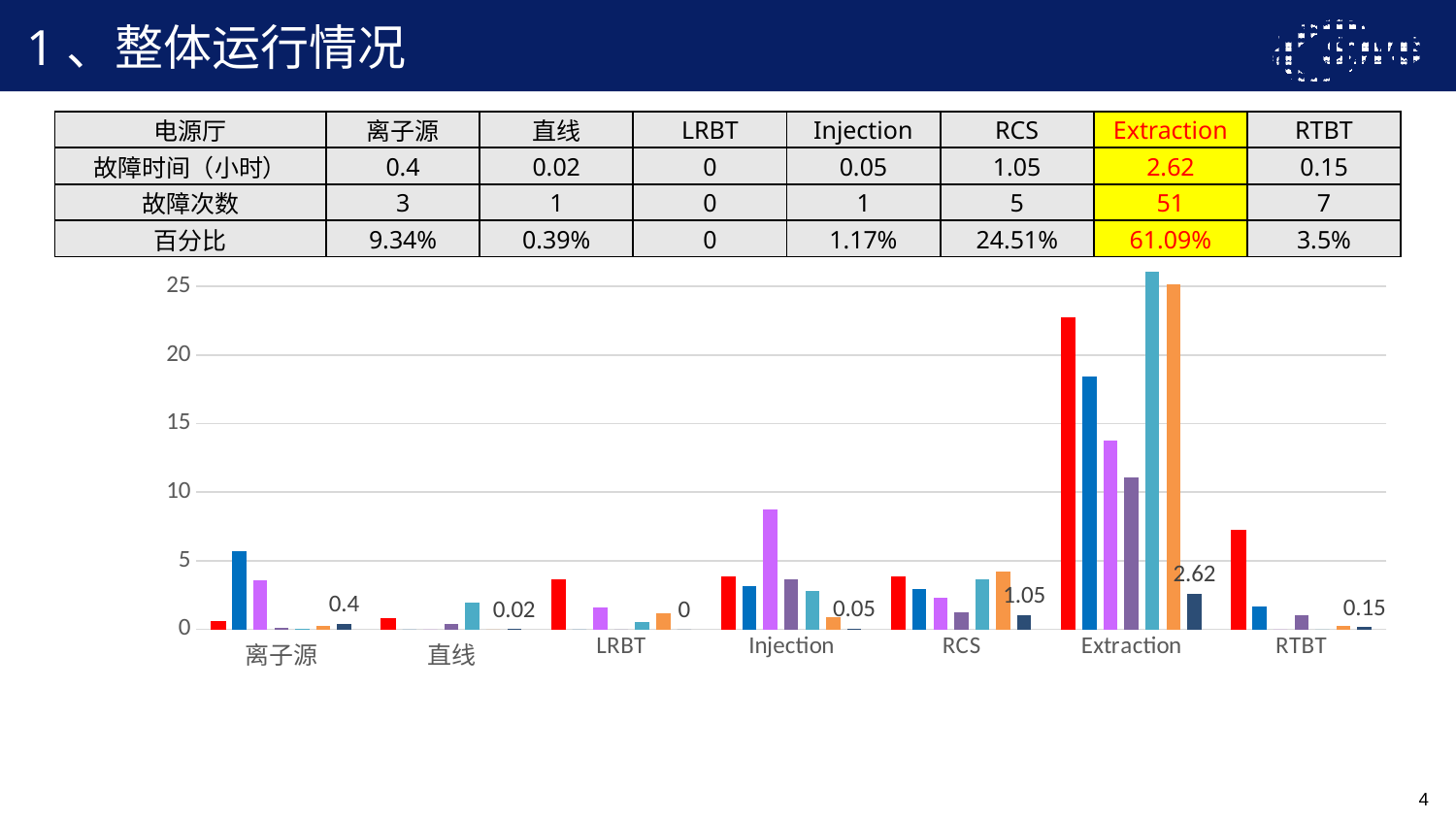
What is the data label shown for the RCS group in the chart? 1.05 How many categories are shown on the x axis of the chart? 7 What is the difference between the labeled values for Extraction (2.62) and RCS (1.05)? 1.57 What is the data label shown for the Extraction group in the chart? 2.62 Which labeled value is larger in the chart: RCS or 离子源? RCS Is the value of the tallest bar in the Injection group greater or less than 10? less What is the highest value shown on the y axis of the chart? 25 What is the data label shown for the RTBT group in the chart? 0.15 What kind of chart is shown on the slide? bar chart What is the data label shown for the 离子源 group in the chart? 0.4 Which category has the tallest bars in the chart? Extraction Is the value of the tallest red bar in the Extraction group greater or less than 20? greater